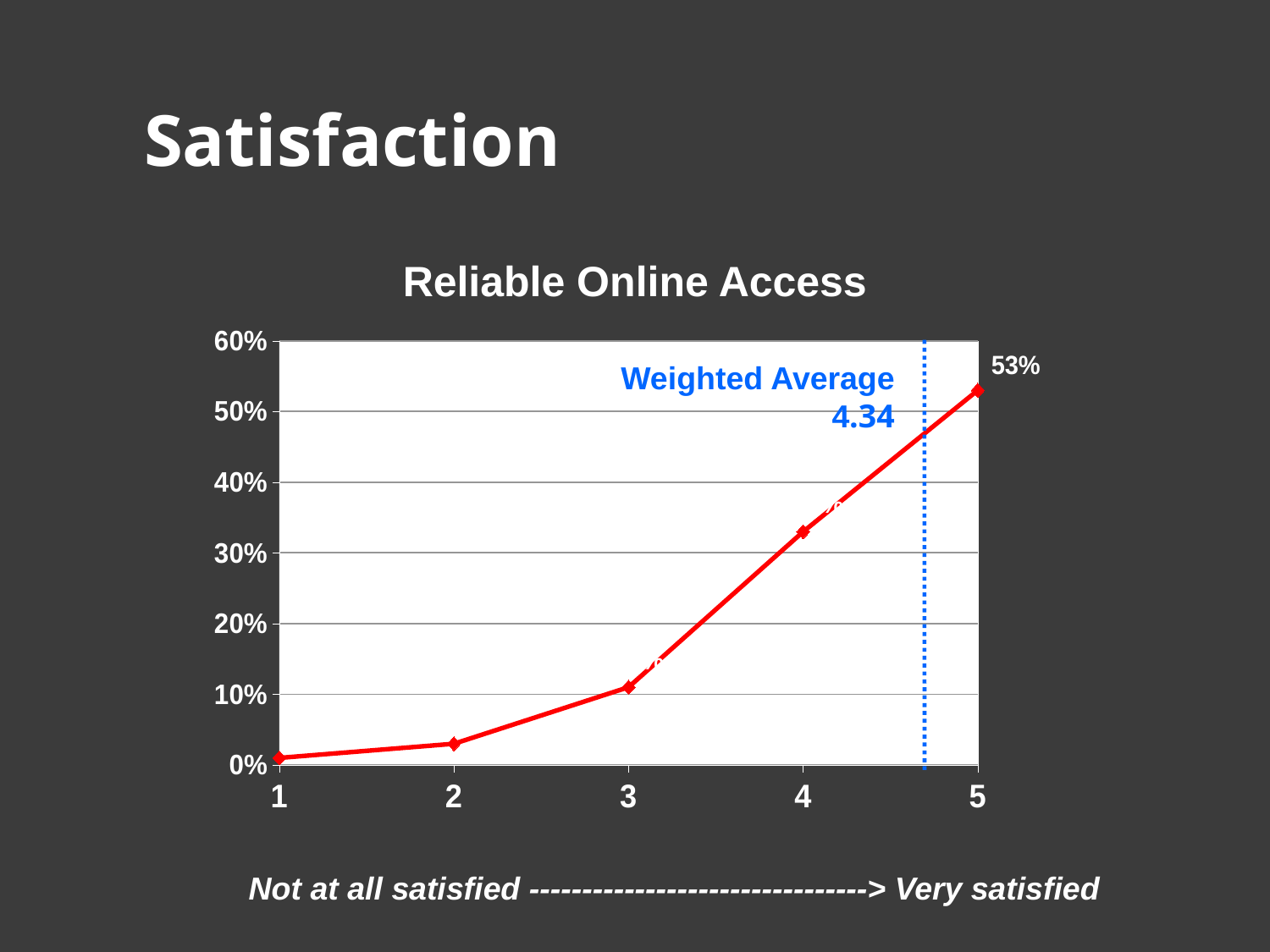
Do the values rise or fall as the rating increases from 1 to 5? rise Is the value for rating 3 greater or less than 20%? less Which rating has the highest value in the chart? 5 Which rating has the lowest value in the chart? 1 Is the value for rating 2 greater or less than 10%? less Which has the larger value, rating 3 or rating 4? 4 How many rating points are plotted on the x axis? 5 What is the value for rating 5 in the Reliable Online Access chart? 53% What is the title of the chart? Reliable Online Access What kind of chart is shown on the slide? line chart What weighted average is shown on the chart? 4.34 Is the value for rating 4 greater or less than 20%? greater